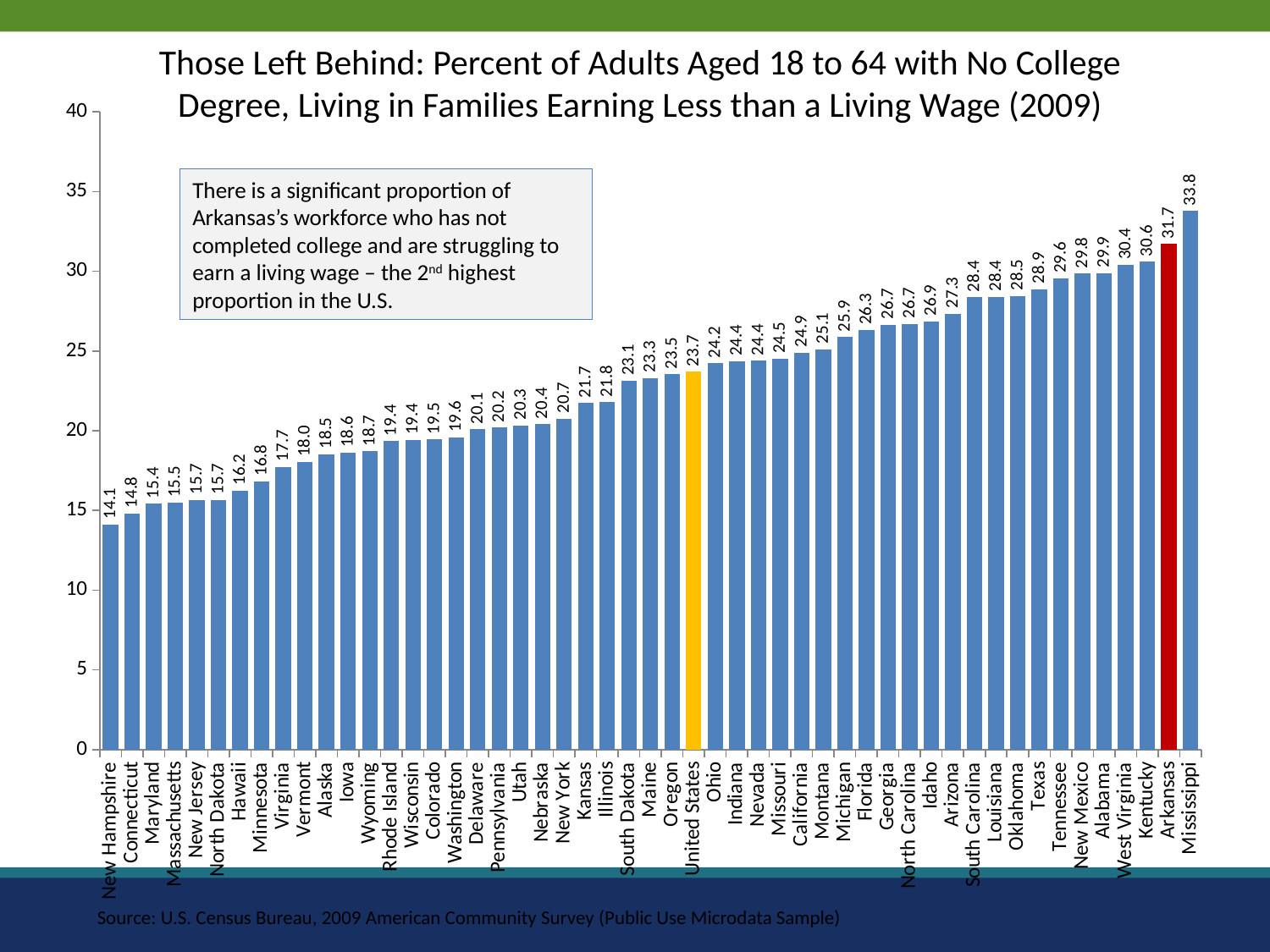
Which category has the highest value? Mississippi What is the value for Mississippi? 33.8 What is the value for United States? 23.7 What kind of chart is shown on the slide? bar chart Which category has the lowest value? New Hampshire Which has a larger value, Texas or Florida? Texas What is the value for Arkansas? 31.7 What is the difference between the values for Arkansas and United States? 8.0 Do the values rise or fall from left to right along the x axis? rise Which category's bar is coloured red? Arkansas What is the value for New Hampshire? 14.1 What is the difference between the values for Mississippi and Arkansas? 2.1